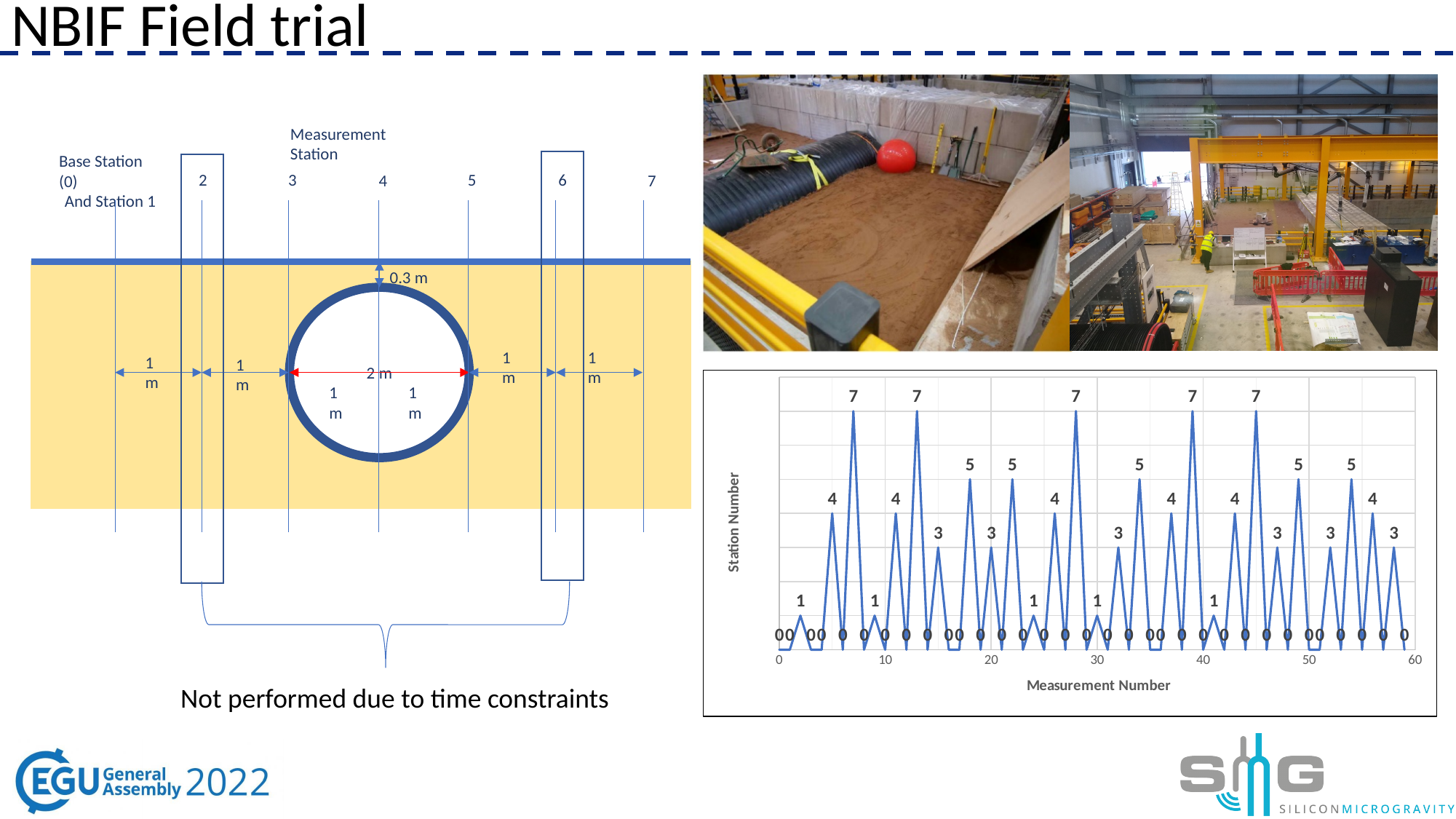
What is the title of the y axis of the line chart? Station Number What is the highest station number reached in the line chart? 7 How many times does the line chart reach station number 1? 5 How many times does the line chart reach station number 7? 5 What is the title of the x axis of the line chart? Measurement Number Does the station number in the line chart rise steadily, fall steadily, or oscillate along the measurement number axis? oscillate What is the difference between the highest and lowest station numbers plotted in the line chart? 7 What type of chart is shown on the right side of the slide? line chart How many times does the line chart reach station number 4? 6 What is the largest tick value shown on the x axis of the line chart? 60 What is the lowest station number plotted in the line chart? 0